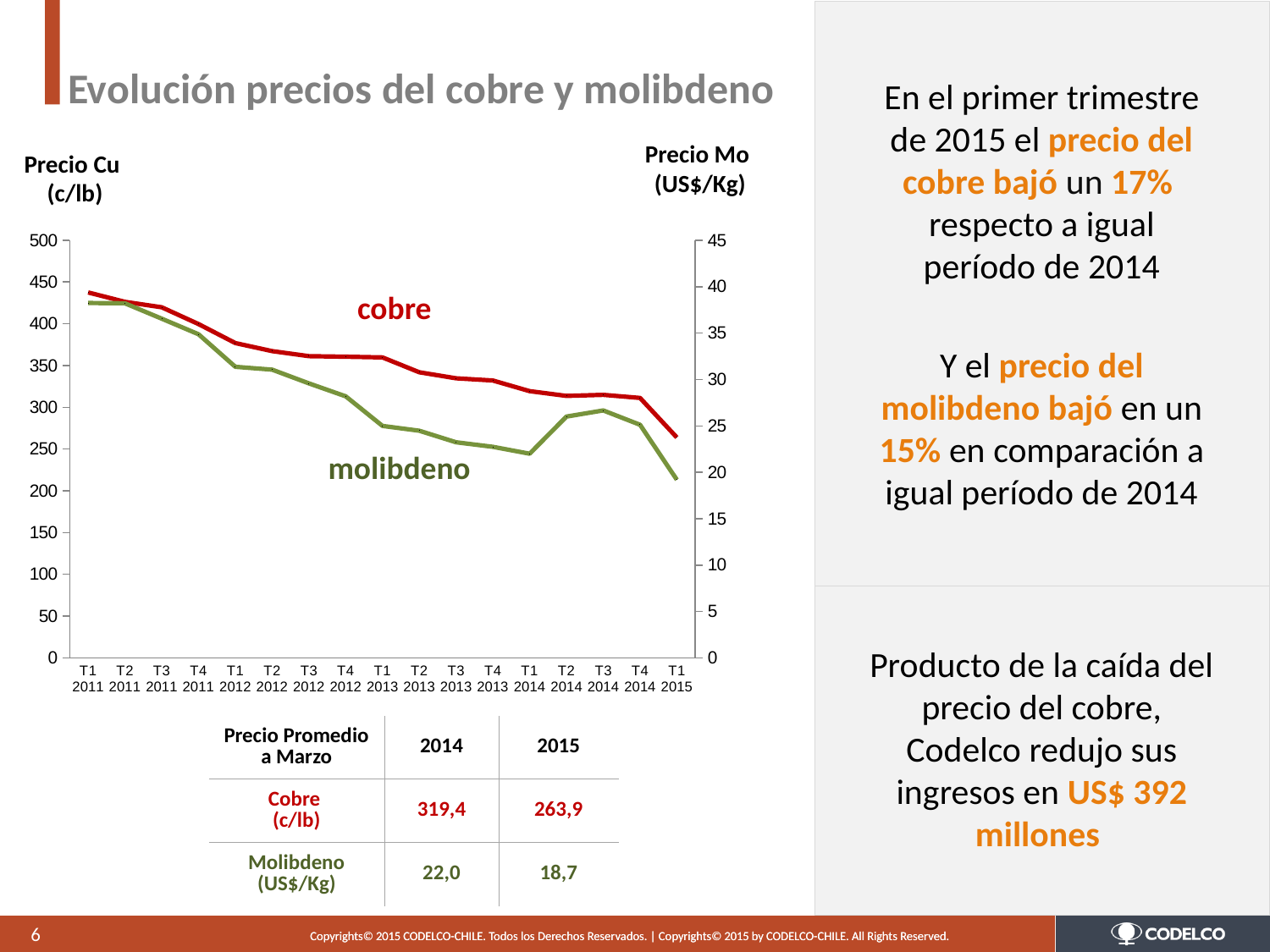
How many series does the chart plot? 2 At which quarter is the cobre price lowest? T1 2015 What kind of chart is shown on the slide? line chart How many quarterly points are shown along the x axis of the chart? 17 At which quarter is the cobre price highest? T1 2011 Is the molibdeno price at T1 2011 greater or less than 35 US$/Kg? greater Is the cobre price at T1 2015 greater or less than 300 c/lb? less Does the molibdeno line rise or fall overall from T1 2011 to T1 2015? fall Does the cobre line rise or fall overall from T1 2011 to T1 2015? fall Is the cobre price at T1 2011 greater or less than 400 c/lb? greater At which quarter is the molibdeno price lowest? T1 2015 Which colour is used for the molibdeno line? green